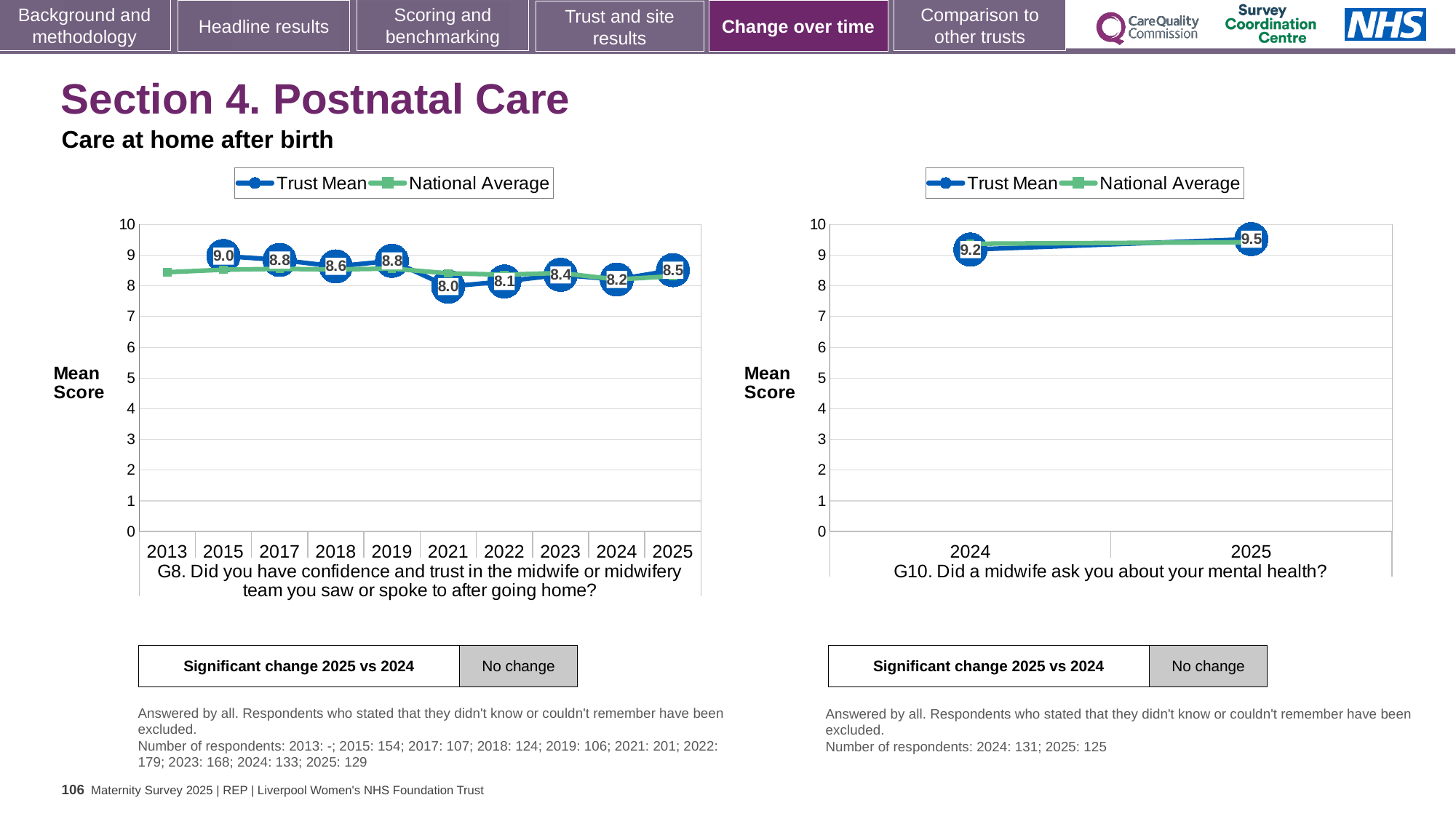
How many series does the legend of the G10 chart list? 2 On the G10 chart, what is the Trust Mean for 2025? 9.5 On the G8 chart, what is the difference between the Trust Mean in 2015 and in 2021? 1.0 On the G8 chart, which year has the highest Trust Mean? 2015 On the G10 chart, what is the Trust Mean for 2024? 9.2 On the G10 chart, what is the difference between the Trust Mean in 2025 and in 2024? 0.3 On the G8 chart, which year has the lowest Trust Mean? 2021 How many years are shown on the x axis of the G8 chart? 10 On the G8 chart, what is the Trust Mean for 2025? 8.5 On the G8 chart, what is the Trust Mean for 2021? 8.0 On the G8 chart, what is the Trust Mean for 2015? 9.0 On the G8 chart, is the Trust Mean higher in 2024 or in 2025? 2025